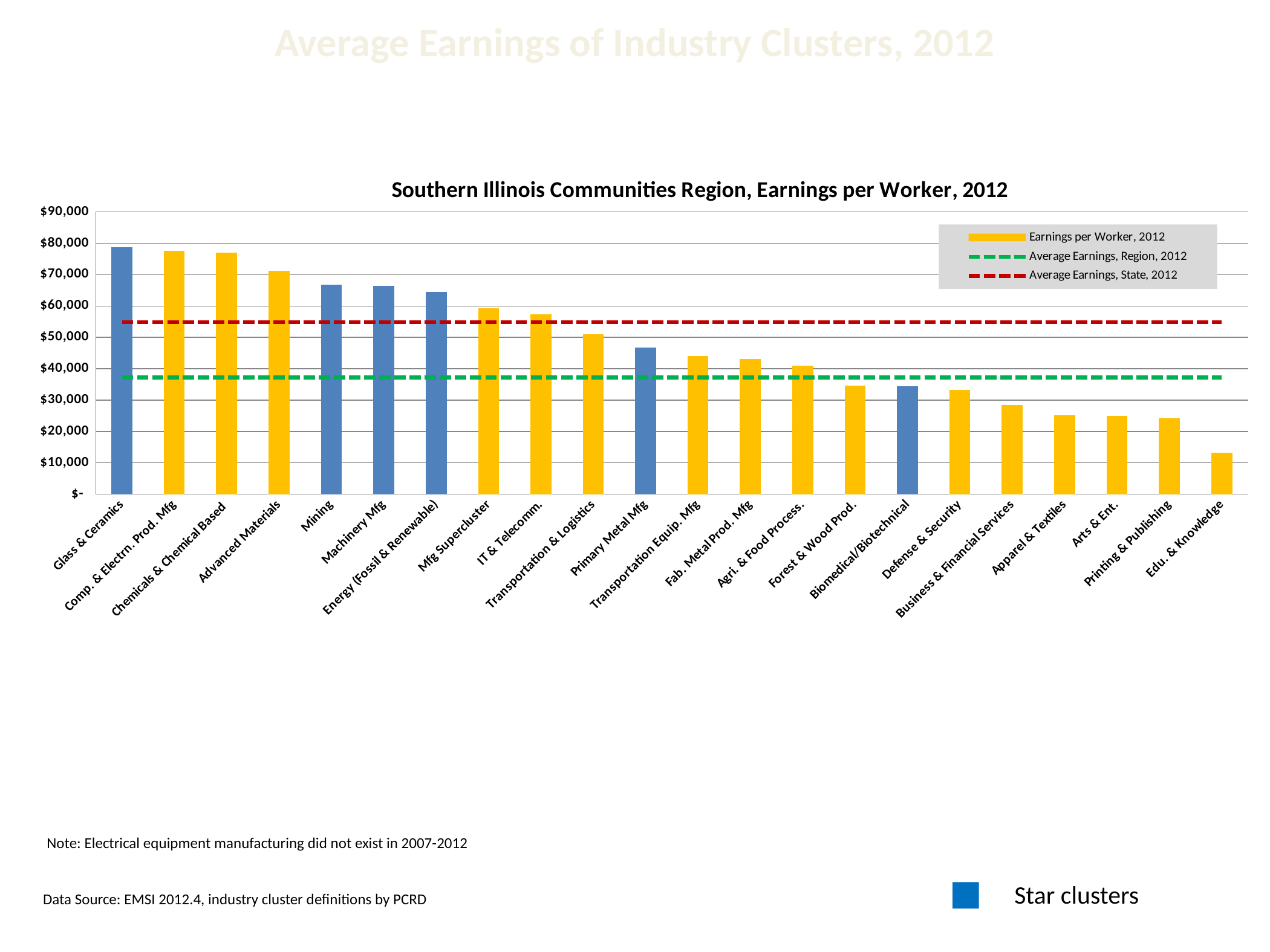
What kind of chart is shown on the slide? bar chart Is the value for Primary Metal Mfg greater or less than $40,000? greater Which industry cluster has the highest earnings per worker? Glass & Ceramics Which industry cluster has the lowest earnings per worker? Edu. & Knowledge Is the value for Forest & Wood Prod. greater or less than $40,000? less Which has higher earnings per worker, Mining or Primary Metal Mfg? Mining How many entries does the legend list? 3 Is the value for Mining greater or less than $60,000? greater How many industry clusters are plotted along the x axis? 22 Do the earnings per worker rise or fall moving from left to right along the x axis? fall What does the red dashed line represent according to the legend? Average Earnings, State, 2012